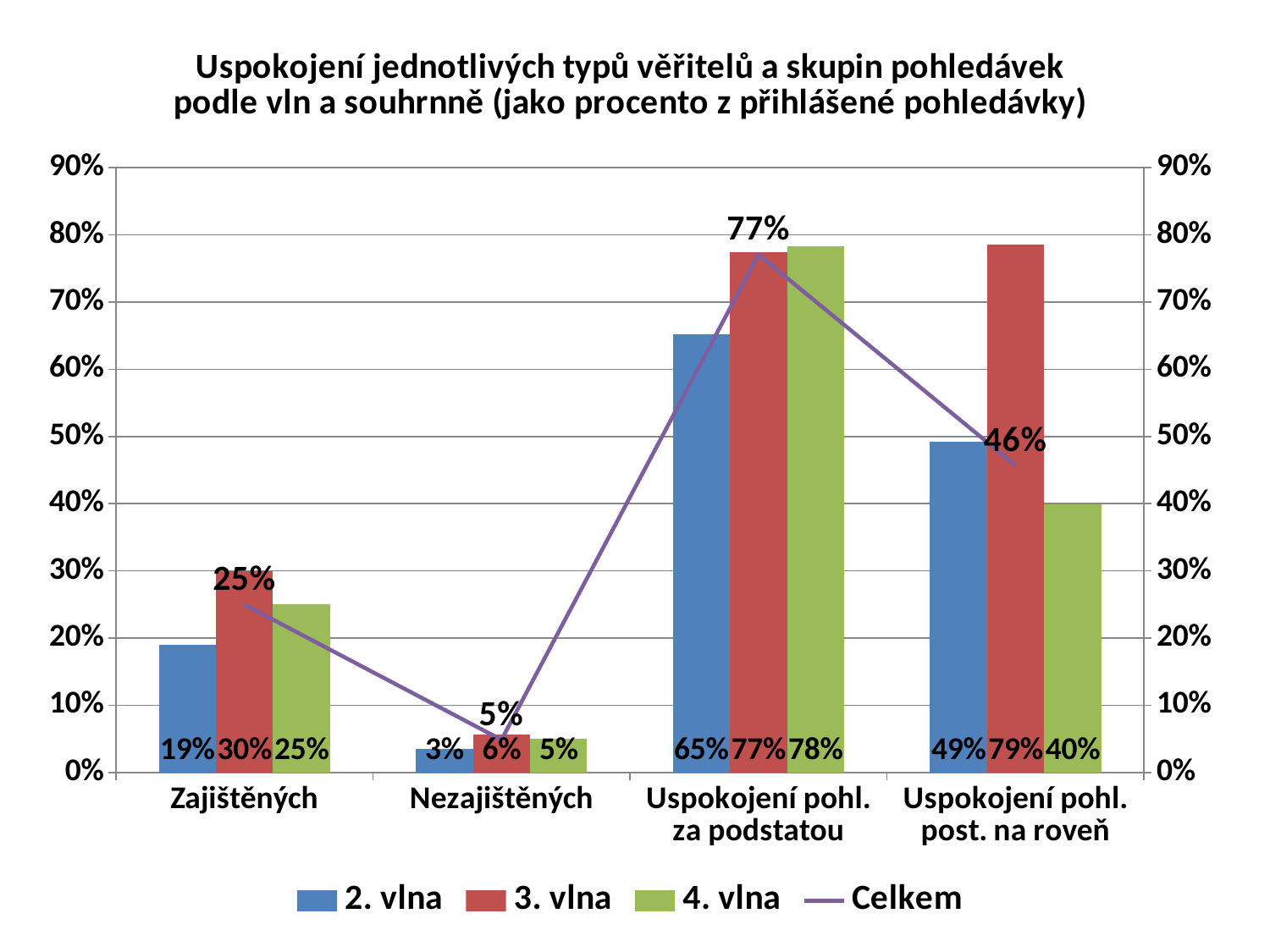
What is the value for 4. vlna in the Uspokojení pohl. post. na roveň category? 40% How many categories are shown on the x axis? 4 Which category has the lowest Celkem value? Nezajištěných What is the value for 3. vlna in the Zajištěných category? 30% What is the Celkem value for the Nezajištěných category? 5% How many series does the legend list? 4 Is the 3. vlna value for Uspokojení pohl. za podstatou greater or less than 70%? greater Which series is drawn as a line rather than bars? Celkem What is the difference between the 3. vlna and 4. vlna values in the Uspokojení pohl. post. na roveň category? 39% Which is larger in the Zajištěných category: the 2. vlna value or the 4. vlna value? 4. vlna What kind of chart is this? Combined bar and line chart Which category has the highest value for 2. vlna? Uspokojení pohl. za podstatou